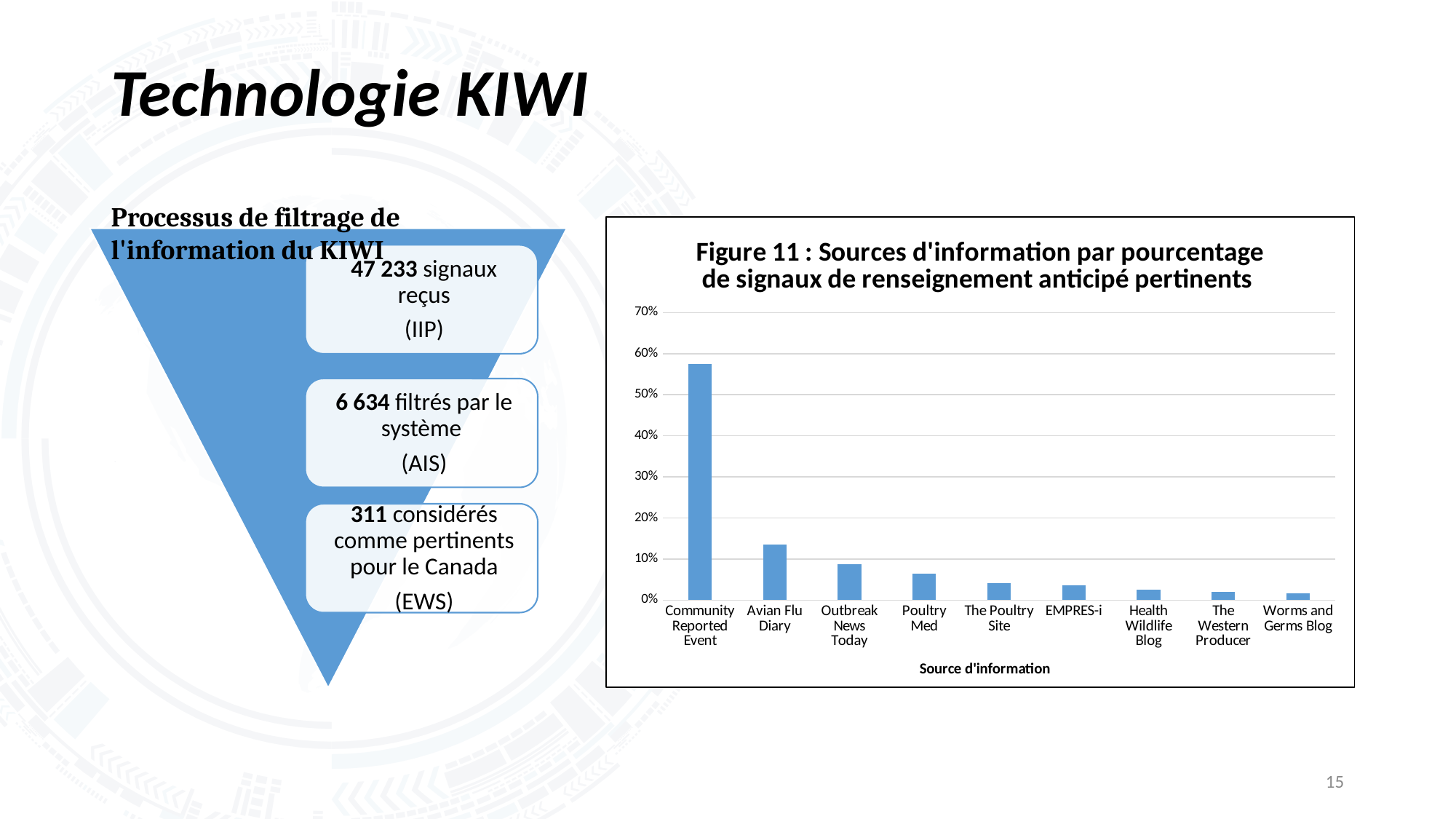
What kind of chart is shown in Figure 11? bar chart Which has a larger value, Avian Flu Diary or Outbreak News Today? Avian Flu Diary What is the highest value shown on the y axis of the chart? 70% Is the value for Outbreak News Today greater or less than 10%? less Which has a larger value, Poultry Med or The Poultry Site? Poultry Med What is the title of the x axis of the chart? Source d'information How many information sources are shown on the x axis of the chart? 9 Is the value for Community Reported Event greater or less than 50%? greater Is the value for Avian Flu Diary greater or less than 10%? greater Do the values rise or fall from left to right along the x axis? fall Which information source has the highest percentage in the chart? Community Reported Event